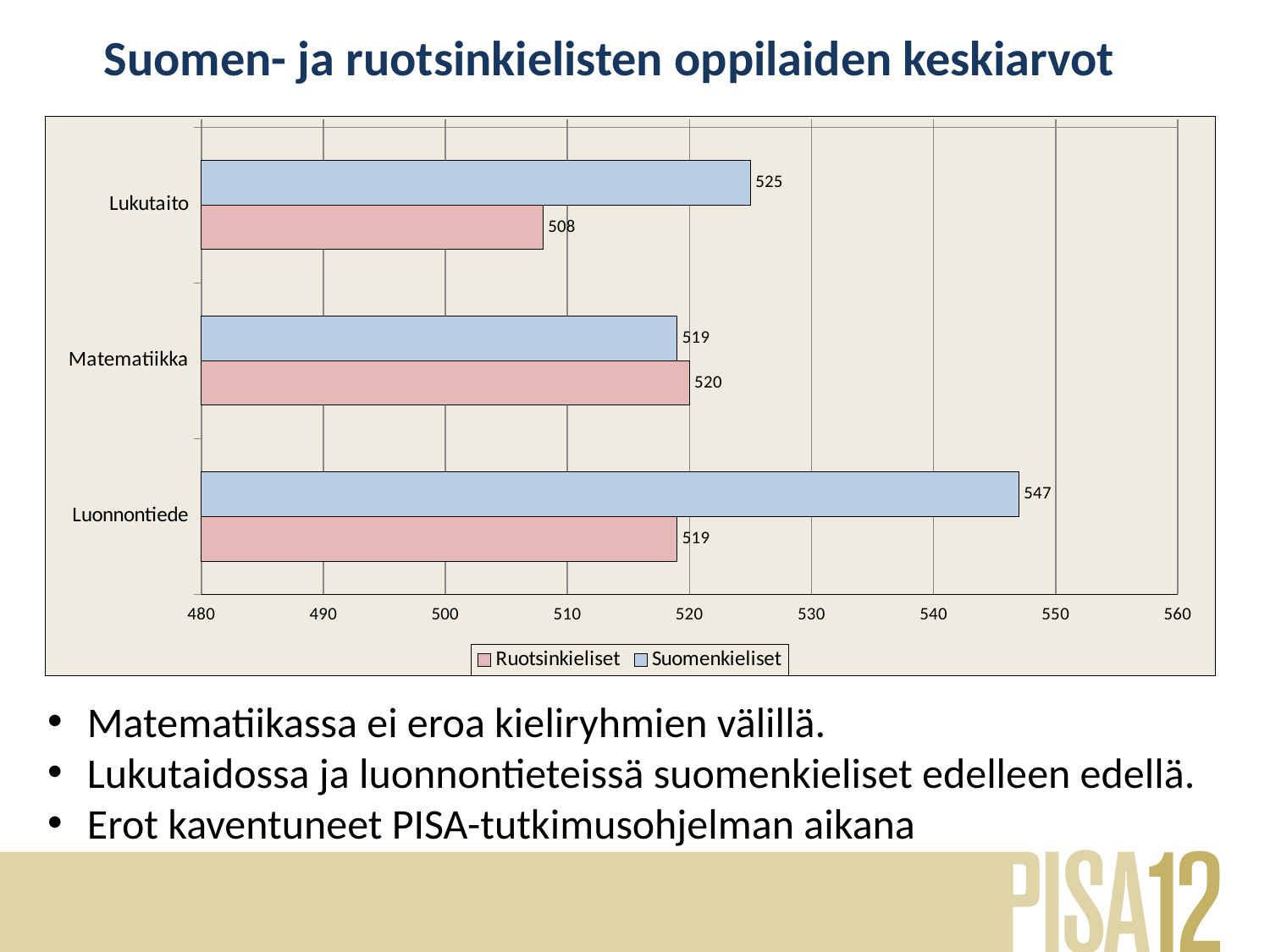
How many series does the legend list? 2 What is the difference between Suomenkieliset and Ruotsinkieliset in Luonnontiede? 28 What is the value for Suomenkieliset in Lukutaito? 525 In which category does Ruotsinkieliset have the lowest value? Lukutaito What is the difference between Suomenkieliset and Ruotsinkieliset in Lukutaito? 17 What is the value for Ruotsinkieliset in Lukutaito? 508 What is the value for Suomenkieliset in Luonnontiede? 547 What is the value for Ruotsinkieliset in Matematiikka? 520 In which category does Suomenkieliset have the highest value? Luonnontiede What kind of chart is shown on the slide? Bar chart Which series has the larger value in Lukutaito, Suomenkieliset or Ruotsinkieliset? Suomenkieliset How many categories are shown on the chart? 3